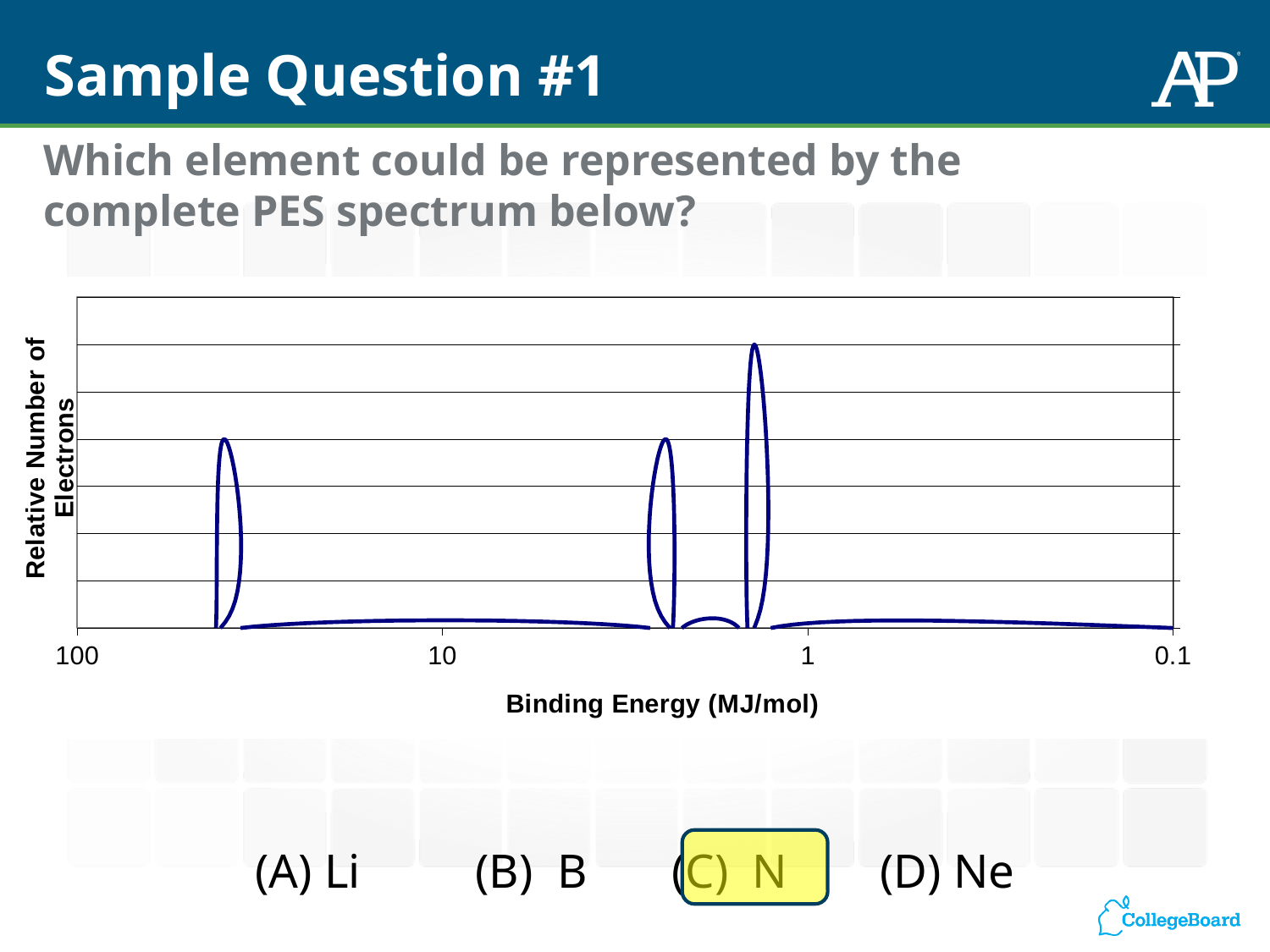
What is the title of the x axis? Binding Energy (MJ/mol) What kind of chart is shown on the slide? line chart Is the binding energy of the leftmost peak greater or less than 10 MJ/mol? greater What value is shown at the right end of the x axis? 0.1 What is the title of the y axis? Relative Number of Electrons Is the binding energy of the middle peak greater or less than 1 MJ/mol? greater Which peak in the spectrum is the tallest: the leftmost, the middle, or the rightmost? rightmost Is the rightmost peak taller or shorter than the leftmost peak? taller How many peaks does the PES spectrum show? 3 Is the binding energy of the tallest peak greater or less than 10 MJ/mol? less What value is shown at the left end of the x axis? 100